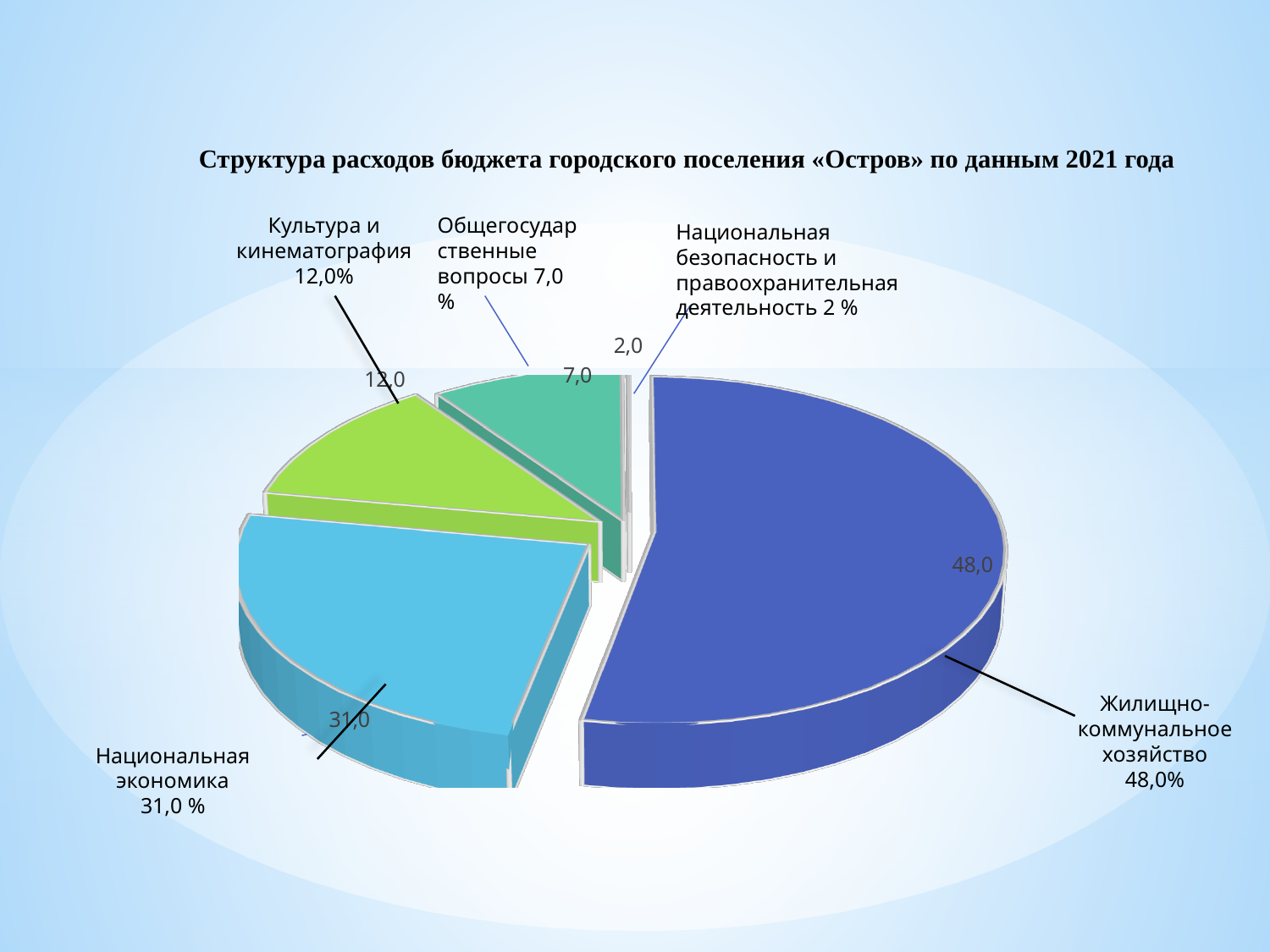
What type of chart is shown on the slide? Pie chart What is the value shown for the Национальная безопасность и правоохранительная деятельность slice? 2,0 What is the value shown for the Жилищно-коммунальное хозяйство slice? 48,0 What is the value shown for the Национальная экономика slice? 31,0 Which category has the largest share of the pie? Жилищно-коммунальное хозяйство How many slices does the pie chart have? 5 What is the value shown for the Культура и кинематография slice? 12,0 What is the title of the chart? Структура расходов бюджета городского поселения «Остров» по данным 2021 года Which category has the smallest share of the pie? Национальная безопасность и правоохранительная деятельность What is the value shown for the Общегосударственные вопросы slice? 7,0 What is the difference between the values for Жилищно-коммунальное хозяйство and Национальная экономика? 17,0 Which is larger, the Культура и кинематография slice or the Общегосударственные вопросы slice? Культура и кинематография